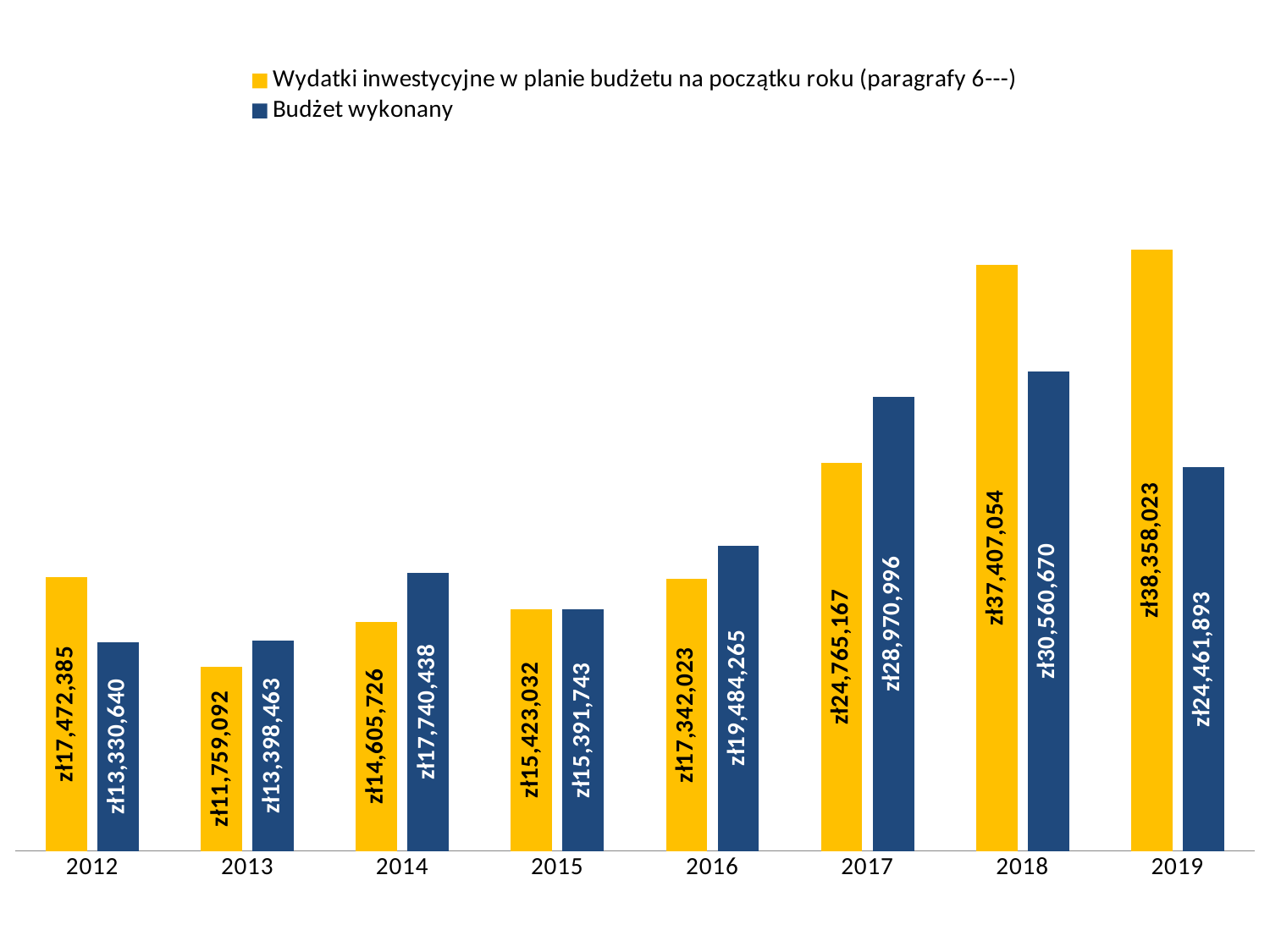
What is the value of 'Budżet wykonany' for 2017? zł28,970,996 How many series does the legend list? 2 What is the value of 'Wydatki inwestycyjne w planie budżetu na początku roku (paragrafy 6---)' for 2014? zł14,605,726 What type of chart is shown on the slide? bar chart What is the difference between the planned investment expenditure and 'Budżet wykonany' in 2019? zł13,896,130 In which year is 'Wydatki inwestycyjne w planie budżetu na początku roku (paragrafy 6---)' highest? 2019 In 2016, which is larger: the planned investment expenditure or 'Budżet wykonany'? Budżet wykonany What is the value of 'Budżet wykonany' for 2019? zł24,461,893 Which colour represents 'Budżet wykonany' in the chart? dark blue How many years are shown on the x axis? 8 In which year is 'Budżet wykonany' highest? 2018 In which year is 'Wydatki inwestycyjne w planie budżetu na początku roku (paragrafy 6---)' lowest? 2013